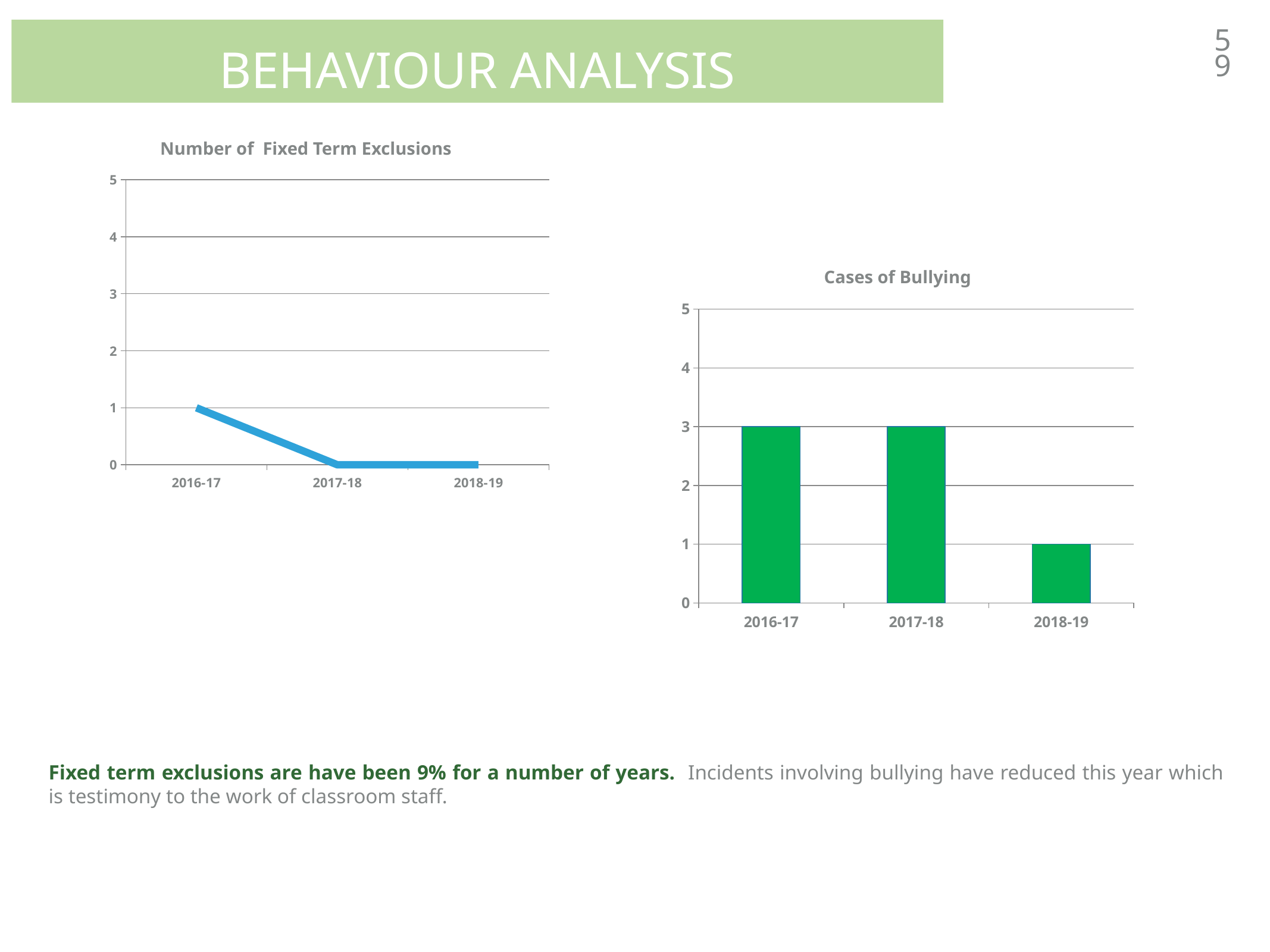
What kind of chart is 'Cases of Bullying'? bar chart In the 'Cases of Bullying' chart, which year has the lowest value? 2018-19 In the 'Cases of Bullying' chart, is the value for 2016-17 greater or less than 2? greater In the 'Cases of Bullying' chart, do the values rise or fall from 2017-18 to 2018-19? fall In the 'Cases of Bullying' chart, what is the value for 2016-17? 3 In the 'Number of Fixed Term Exclusions' chart, what is the value for 2018-19? 0 In the 'Cases of Bullying' chart, what is the value for 2018-19? 1 In the 'Number of Fixed Term Exclusions' chart, what is the value for 2016-17? 1 In the 'Cases of Bullying' chart, what is the difference between the values for 2017-18 and 2018-19? 2 How many years are shown on the x axis of the 'Cases of Bullying' chart? 3 In the 'Number of Fixed Term Exclusions' chart, which year has the highest value? 2016-17 What kind of chart is 'Number of Fixed Term Exclusions'? line chart